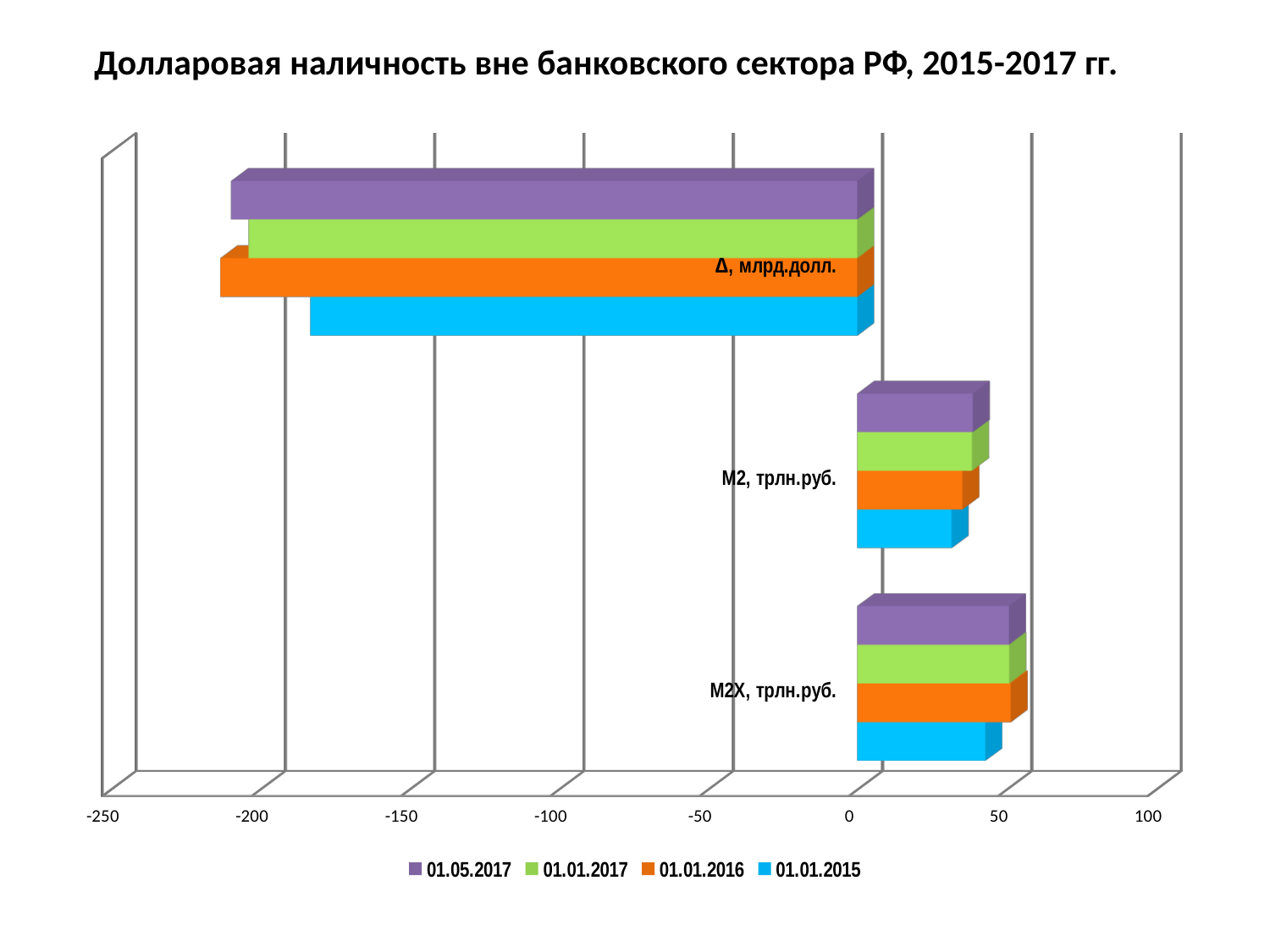
Is the value for M2X, трлн.руб. on 01.01.2016 greater or less than 0? greater Which colour represents the 01.01.2015 series in the legend? blue Is the value for Δ, млрд.долл. on 01.01.2015 greater or less than -150? less For Δ, млрд.долл., which is larger: the value on 01.01.2015 or on 01.01.2016? 01.01.2015 Which category has the highest values across all series? M2X, трлн.руб. How many categories are plotted on the chart? 3 Is the value for M2, трлн.руб. on 01.01.2015 greater or less than 50? less What kind of chart is shown on the slide? bar chart How many series does the legend list? 4 For 01.01.2015, which is larger: M2, трлн.руб. or M2X, трлн.руб.? M2X, трлн.руб. What is the title of the chart? Долларовая наличность вне банковского сектора РФ, 2015-2017 гг. Which category has negative values for all series? Δ, млрд.долл.